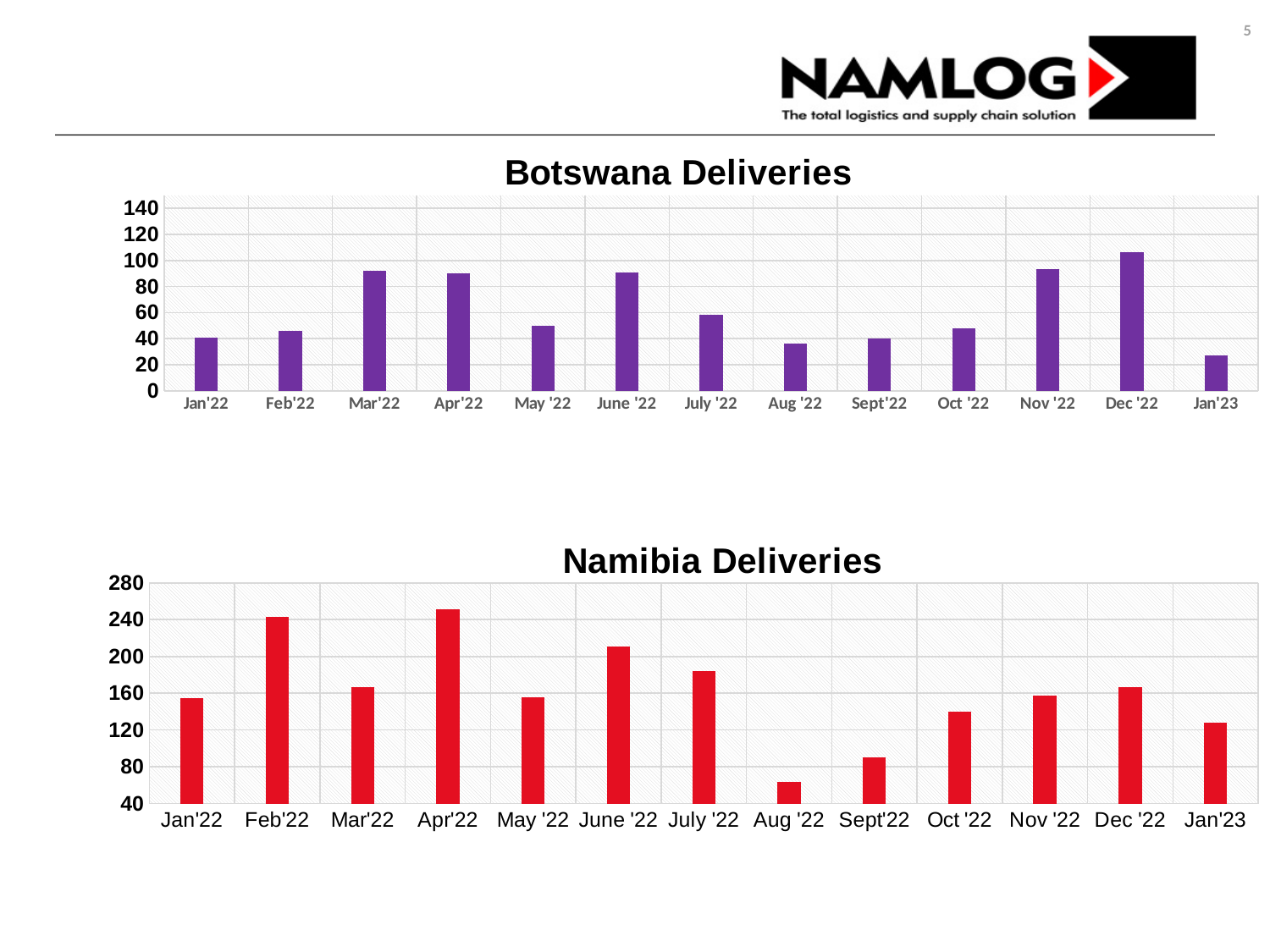
In the Namibia Deliveries chart, is the value for June '22 greater or less than 200? greater In the Namibia Deliveries chart, which month has the lowest value? Aug '22 In the Botswana Deliveries chart, is the value for Dec '22 greater or less than 100? greater In the Namibia Deliveries chart, is the value for Aug '22 greater or less than 80? less In the Namibia Deliveries chart, which is larger, Feb'22 or Mar'22? Feb'22 What colour are the bars in the Botswana Deliveries chart? purple In the Botswana Deliveries chart, which month has the lowest value? Jan'23 How many months are shown in the Botswana Deliveries chart? 13 In the Botswana Deliveries chart, which month has the highest value? Dec '22 In the Botswana Deliveries chart, which is larger, Mar'22 or May '22? Mar'22 What kind of chart is the Namibia Deliveries chart? bar chart